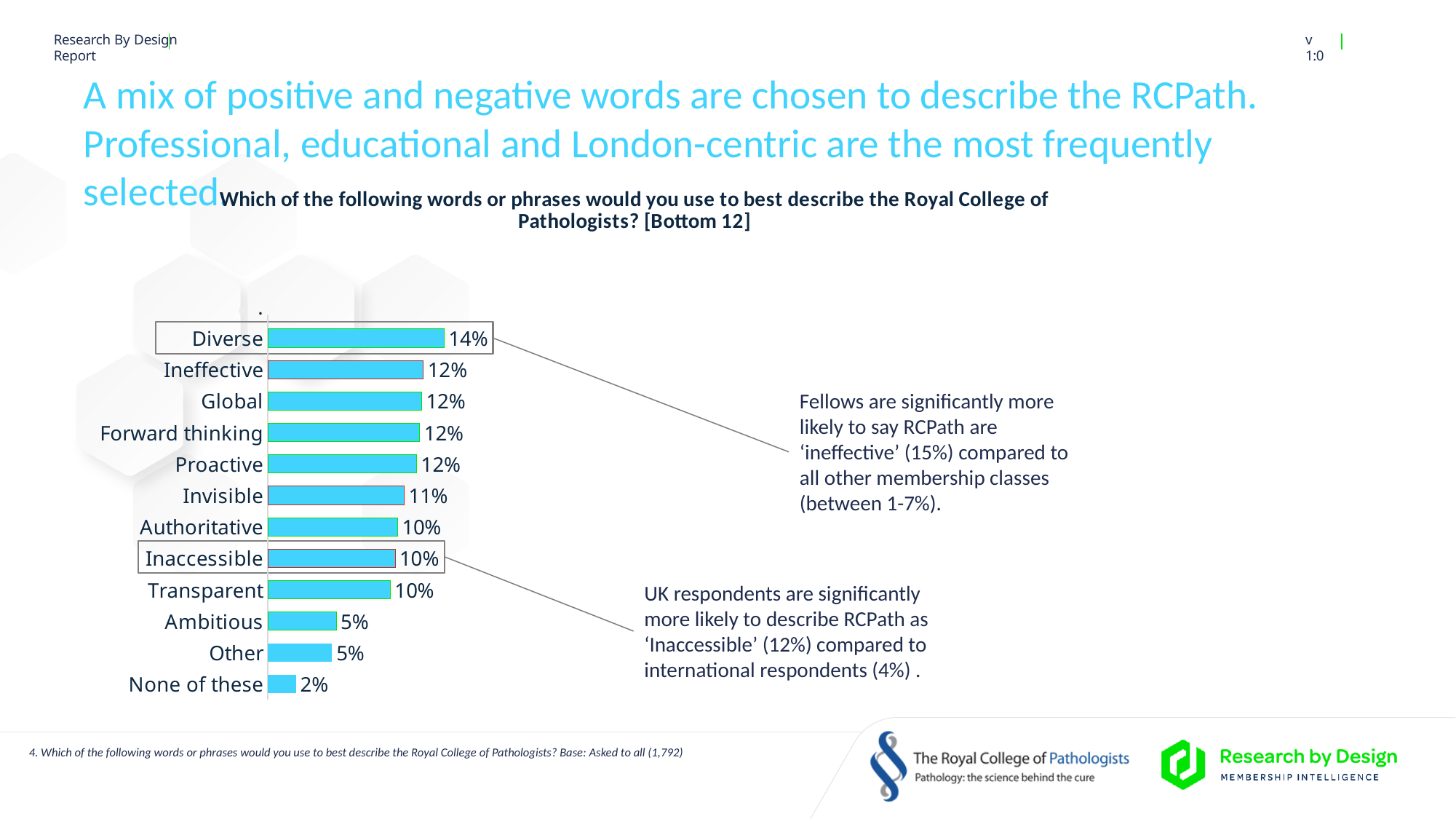
How many categories are plotted in the chart? 12 What is the value for 'Ambitious'? 5% What type of chart is shown on the slide? Bar chart What is the value shown for 'Invisible'? 11% What percentage is shown for 'None of these'? 2% What percentage of respondents chose 'Diverse' to describe the Royal College of Pathologists? 14% Which has a larger value, 'Authoritative' or 'Ambitious'? Authoritative What is the difference between the percentages for 'Diverse' and 'Transparent'? 4% Which word has the highest percentage in the chart? Diverse Which category has the lowest percentage in the chart? None of these What is the title of the chart? Which of the following words or phrases would you use to best describe the Royal College of Pathologists? [Bottom 12] What is the difference between the values for 'Invisible' and 'None of these'? 9%